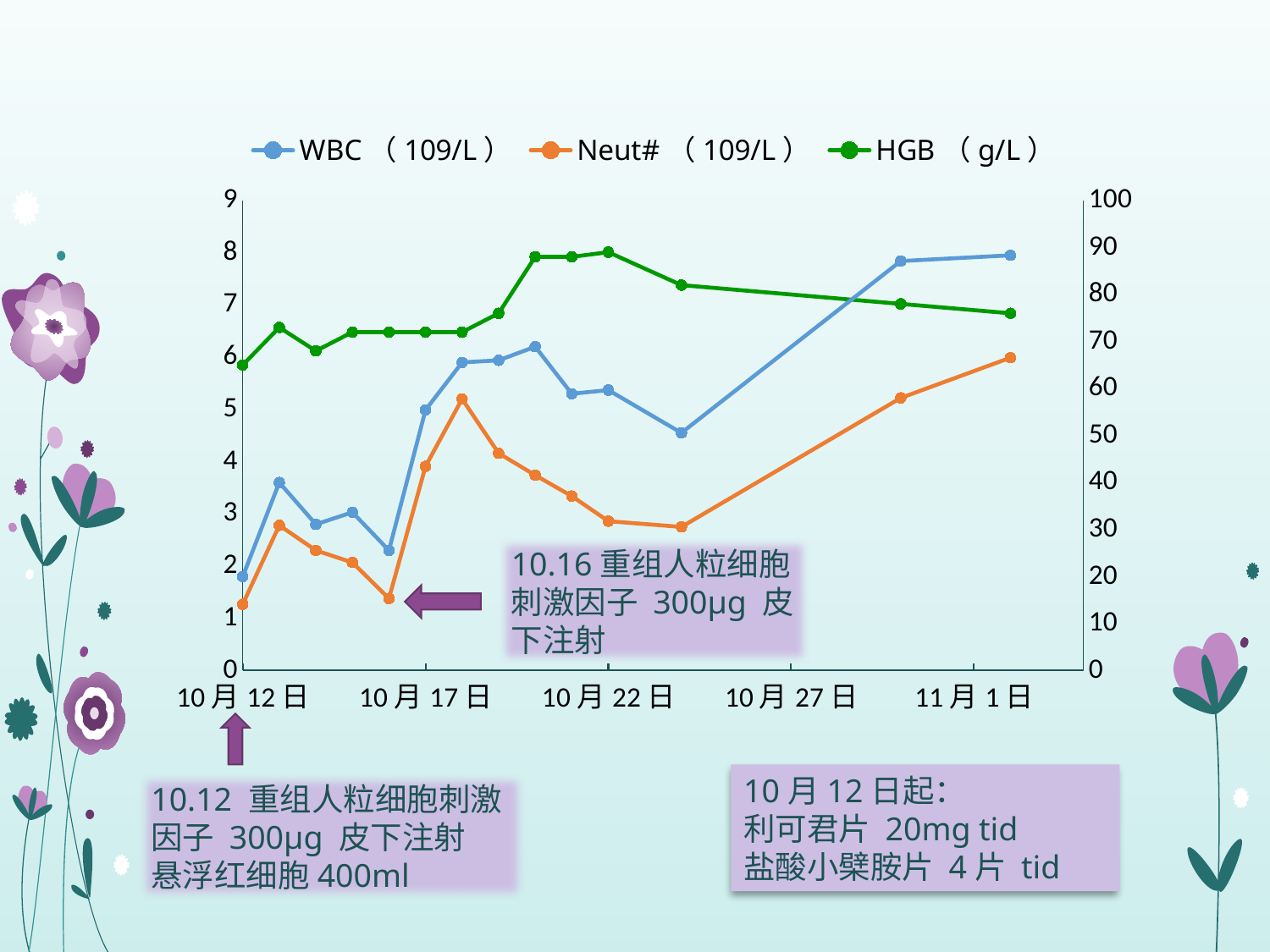
On 10月12日, which is larger, the WBC value or the Neut# value? WBC How many series does the legend list? 3 What kind of chart is shown on the slide? line chart Does the Neut# series rise or fall between 10月22日 and 11月1日? rise Is the Neut# value on 11月1日 greater or less than 5? greater Is the highest HGB value greater or less than 80? greater Does the HGB series rise or fall between 10月22日 and 11月1日? fall What is the maximum value shown on the right-hand vertical axis? 100 Which series is drawn in green? HGB（g/L） Is the WBC value on 11月1日 greater or less than 7? greater